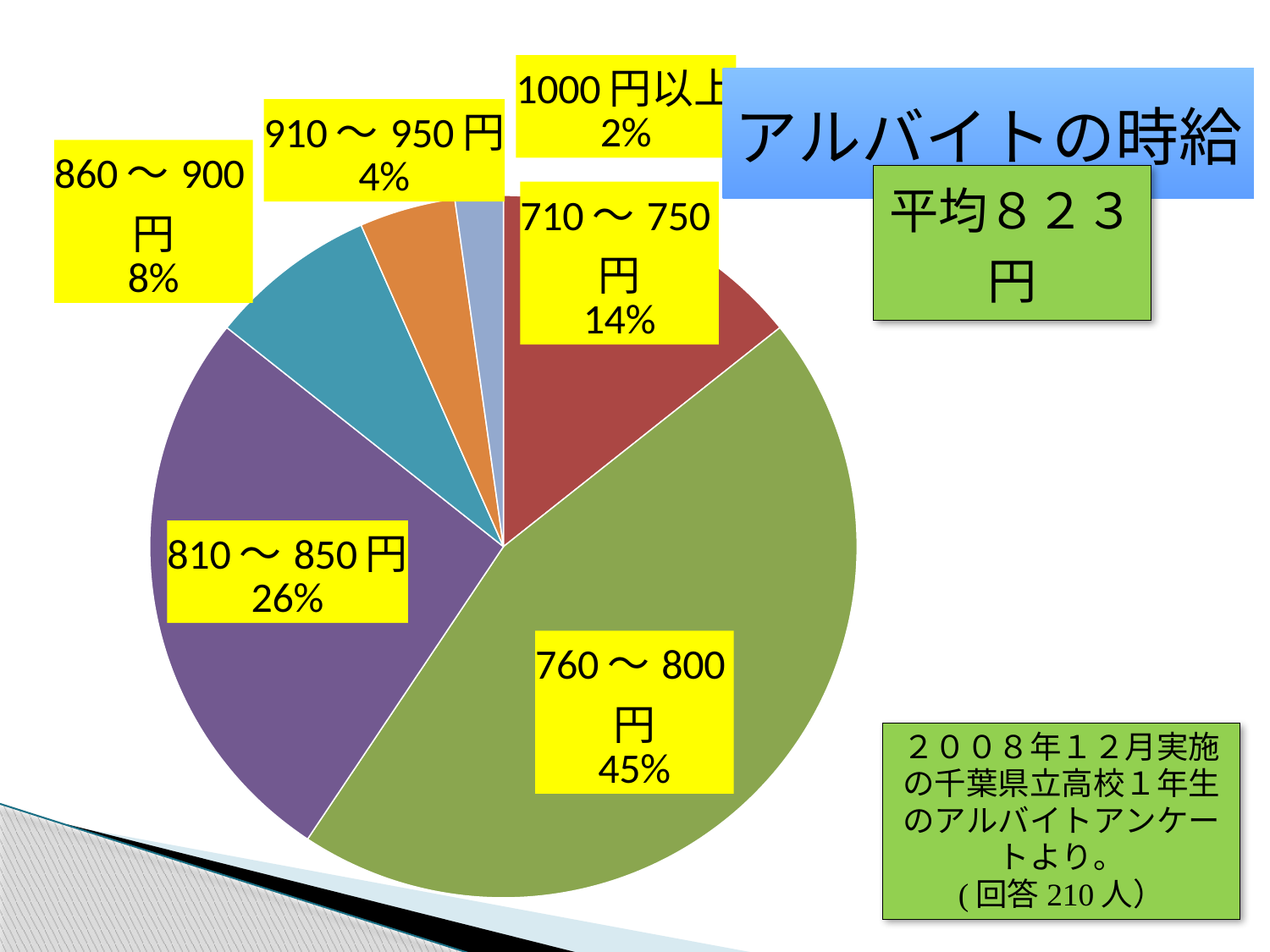
Which wage range has the largest share of the pie? 760〜800円 What kind of chart is shown on the slide? pie chart Which wage range has the smallest share of the pie? 1000円以上 What percentage of the pie is the 710〜750円 slice? 14% What percentage of the pie is the 760〜800円 slice? 45% What is the title of the chart? アルバイトの時給 How many slices does the pie chart have? 6 What percentage of the pie is the 1000円以上 slice? 2% Which slice is larger, 910〜950円 or 860〜900円? 860〜900円 What percentage of the pie is the 810〜850円 slice? 26% What is the difference in percentage points between the 760〜800円 slice and the 810〜850円 slice? 19 What percentage of the pie is the 860〜900円 slice? 8%